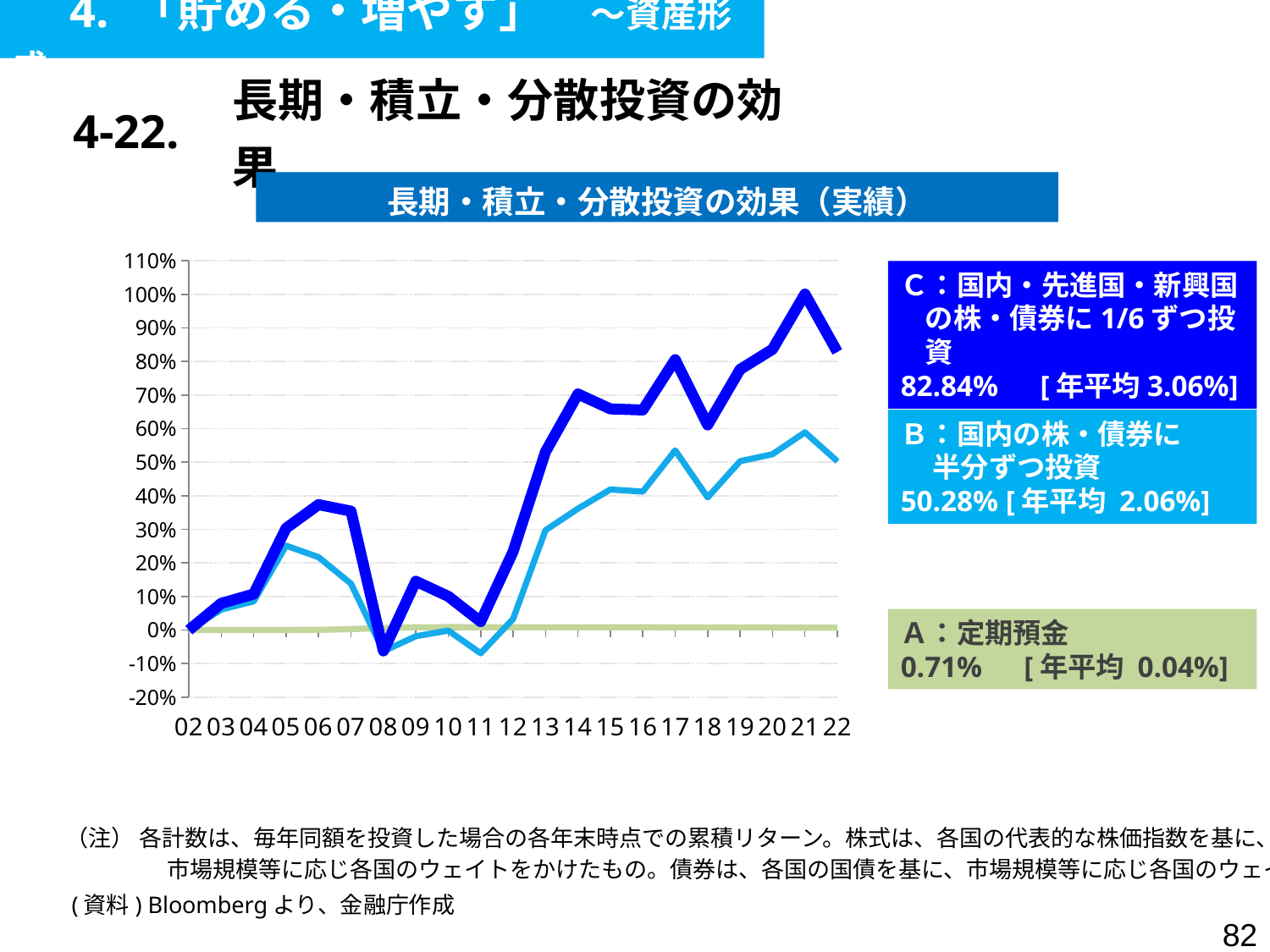
Which series has the lowest cumulative return at the end of the period? A Which series has the highest cumulative return at the end of the period? C What is the cumulative return shown for series B (国内の株・債券に半分ずつ投資)? 50.28% How many years are shown along the x axis of the chart? 21 How many investment series (A, B, C) are plotted in the chart? 3 Does series C rise or fall from 2018 to 2021? rise What is the cumulative return shown for series C (国内・先進国・新興国の株・債券に1/6ずつ投資)? 82.84% What is the annual average return shown for series A (定期預金)? 0.04% What is the title of the chart? 長期・積立・分散投資の効果（実績） What kind of chart is shown on the slide? line chart Is the value for series C in 2021 greater or less than 90%? greater What is the difference between the cumulative returns of series C (82.84%) and series B (50.28%)? 32.56%